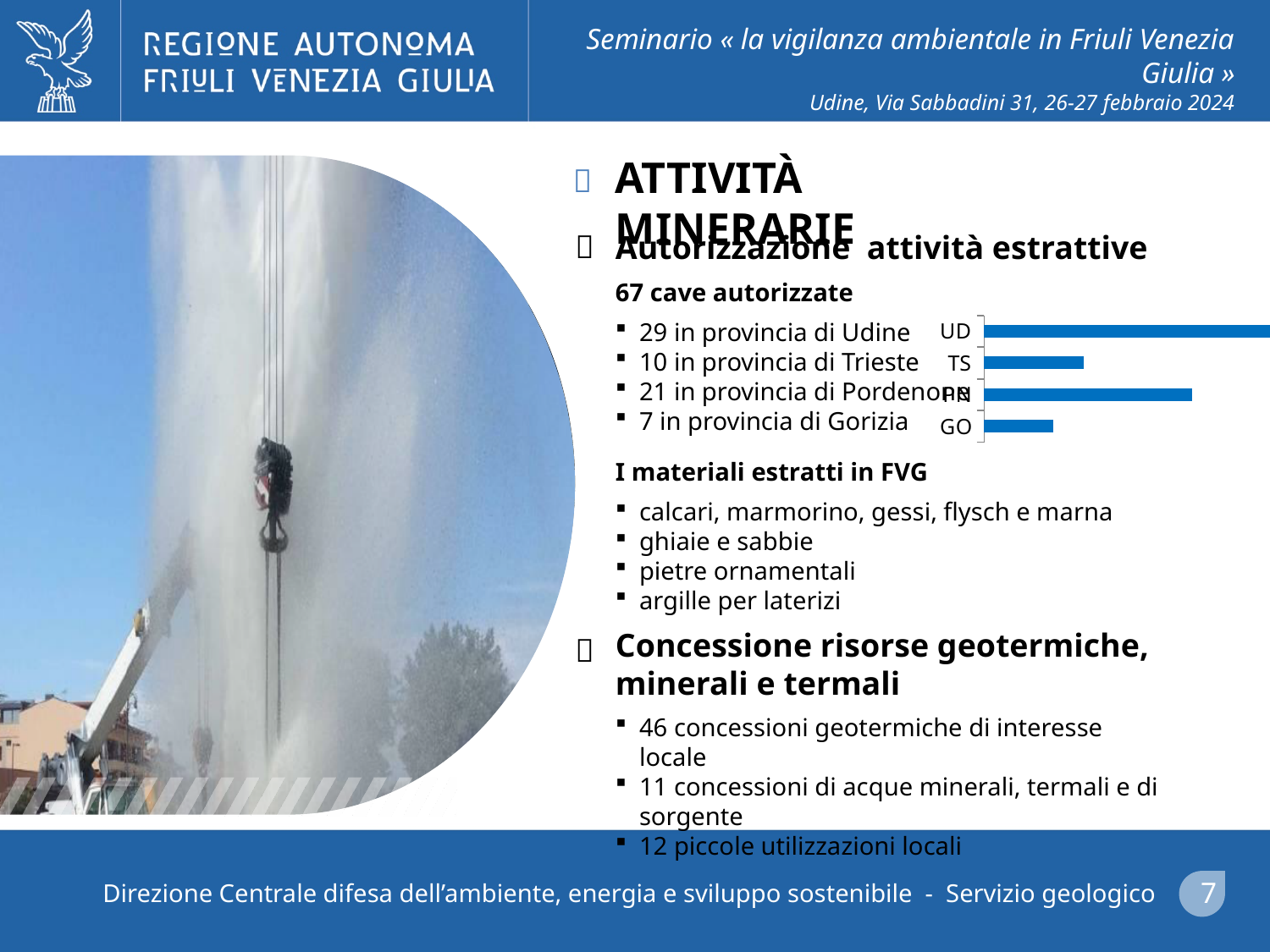
What are the category labels on the bar chart, from top to bottom? UD, TS, PN, GO In the bar chart, which has the smaller value, TS or GO? GO In the bar chart, which has the larger value, UD or PN? UD What kind of chart is shown on the slide next to the list of authorized quarries? bar chart Are the bars in the chart drawn horizontally or vertically? horizontally How many categories does the bar chart show? 4 Which category has the shortest bar in the chart? GO In the bar chart, is the bar for PN longer or shorter than the bar for TS? longer Which category has the longest bar in the chart? UD